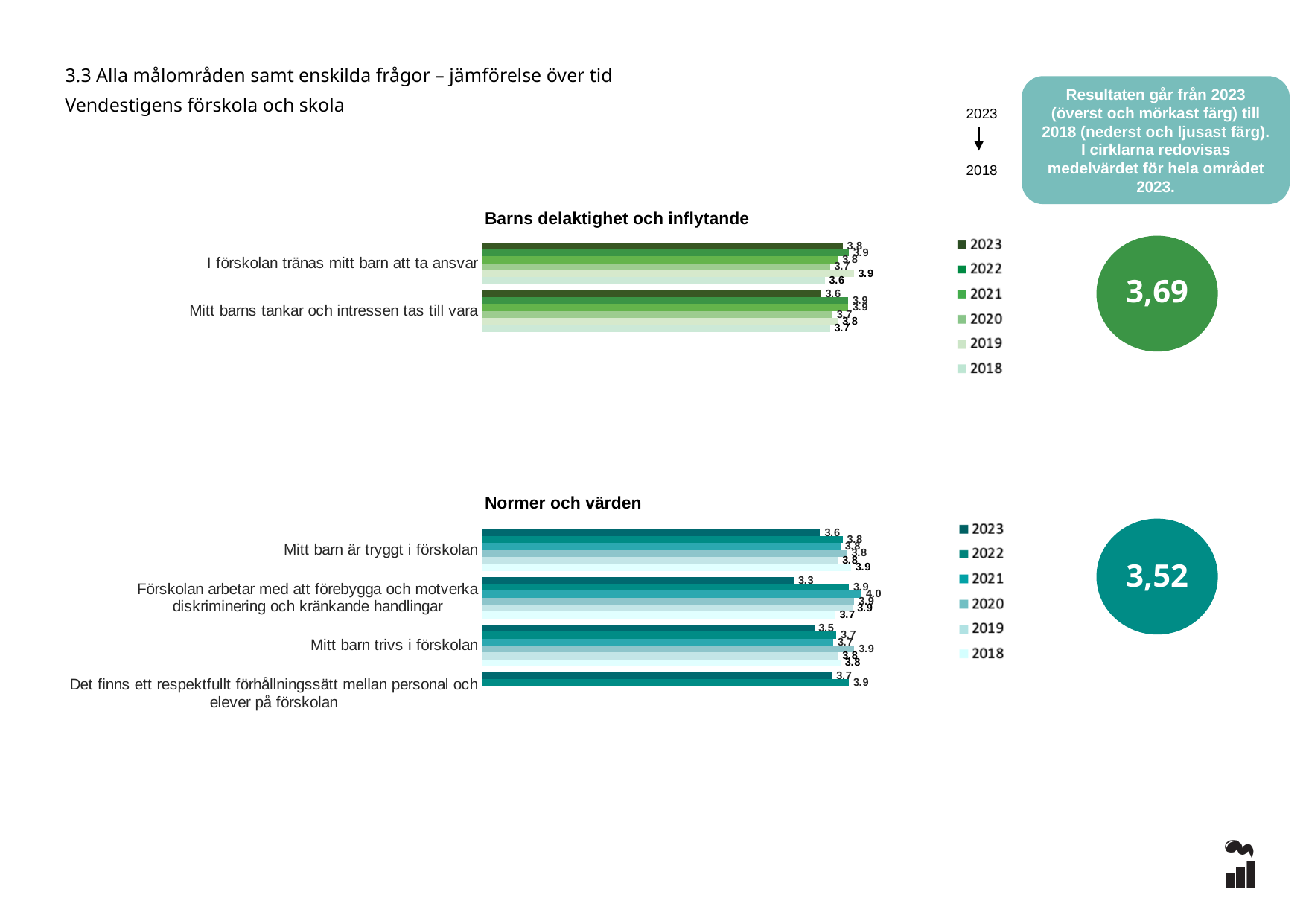
In the 'Normer och värden' chart, what is the 2023 value for 'Mitt barn trivs i förskolan'? 3.5 In the 'Normer och värden' chart, which has the higher 2023 value: 'Mitt barn är tryggt i förskolan' or 'Mitt barn trivs i förskolan'? Mitt barn är tryggt i förskolan In the 'Normer och värden' chart, which category has the lowest 2023 value? Förskolan arbetar med att förebygga och motverka diskriminering och kränkande handlingar In the 'Barns delaktighet och inflytande' chart, what is the 2023 value for 'I förskolan tränas mitt barn att ta ansvar'? 3.8 In the 'Normer och värden' chart, what is the difference between the 2022 and 2023 values for 'Det finns ett respektfullt förhållningssätt mellan personal och elever på förskolan'? 0.2 In the 'Normer och värden' chart, what is the 2023 value for 'Förskolan arbetar med att förebygga och motverka diskriminering och kränkande handlingar'? 3.3 What type of chart is used for 'Barns delaktighet och inflytande'? Bar chart How many series does the legend of the 'Barns delaktighet och inflytande' chart list? 6 In the 'Barns delaktighet och inflytande' chart, what is the 2023 value for 'Mitt barns tankar och intressen tas till vara'? 3.6 In the 'Normer och värden' chart, what is the 2022 value for 'Det finns ett respektfullt förhållningssätt mellan personal och elever på förskolan'? 3.9 In the 'Barns delaktighet och inflytande' chart, what is the 2018 value for 'I förskolan tränas mitt barn att ta ansvar'? 3.6 How many categories (questions) are shown in the 'Normer och värden' chart? 4